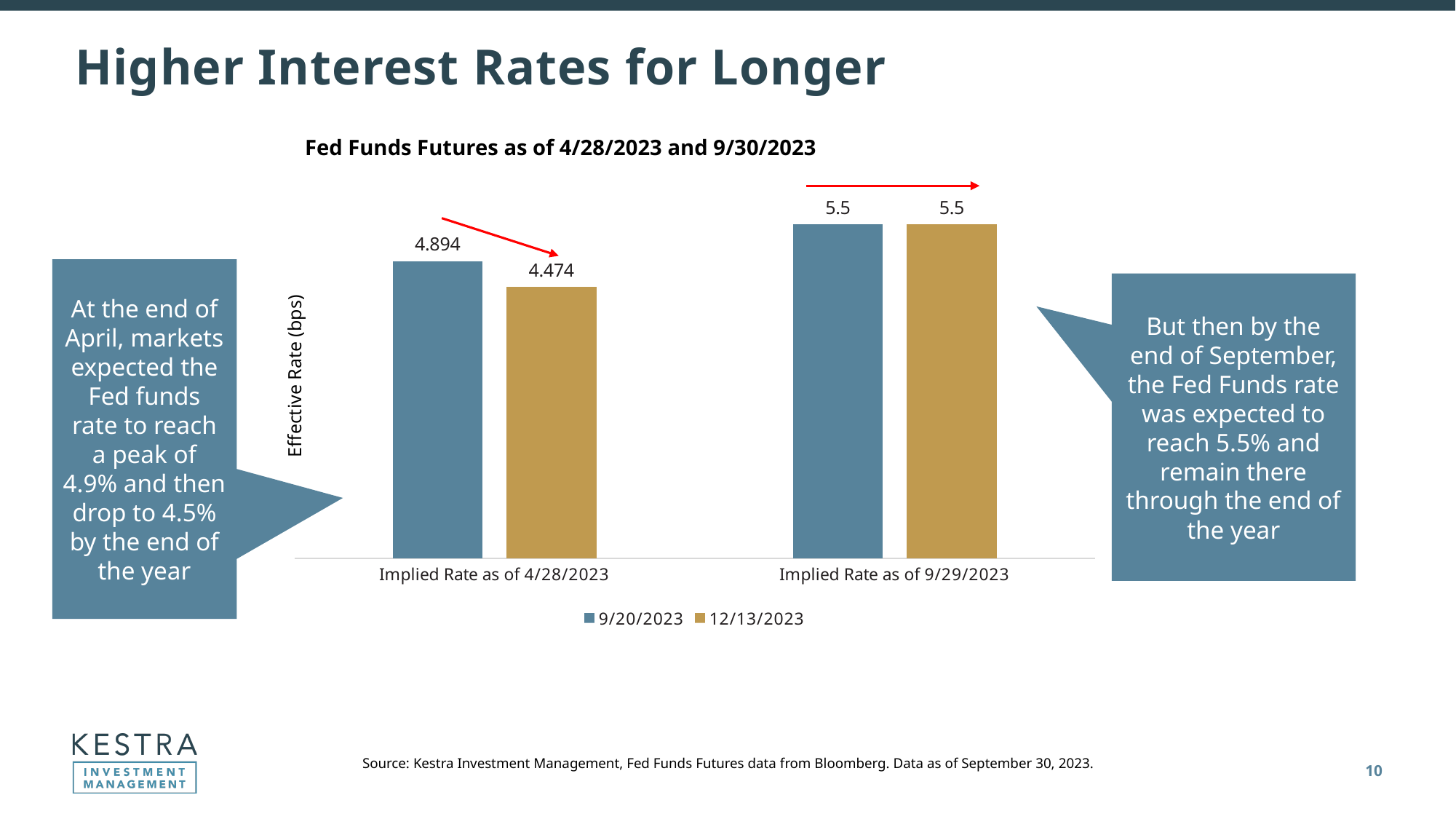
What is the 9/20/2023 value for Implied Rate as of 9/29/2023? 5.5 For Implied Rate as of 4/28/2023, which series has the larger value, 9/20/2023 or 12/13/2023? 9/20/2023 What is the title of the chart? Fed Funds Futures as of 4/28/2023 and 9/30/2023 Which category has the highest 9/20/2023 value? Implied Rate as of 9/29/2023 How many categories are shown on the x axis? 2 How many series does the legend list? 2 What kind of chart is shown on the slide? Bar chart Which category has the lowest 12/13/2023 value? Implied Rate as of 4/28/2023 What is the 9/20/2023 value for Implied Rate as of 4/28/2023? 4.894 What is the 12/13/2023 value for Implied Rate as of 9/29/2023? 5.5 What is the difference between the 9/20/2023 and 12/13/2023 values for Implied Rate as of 4/28/2023? 0.420 What is the 12/13/2023 value for Implied Rate as of 4/28/2023? 4.474